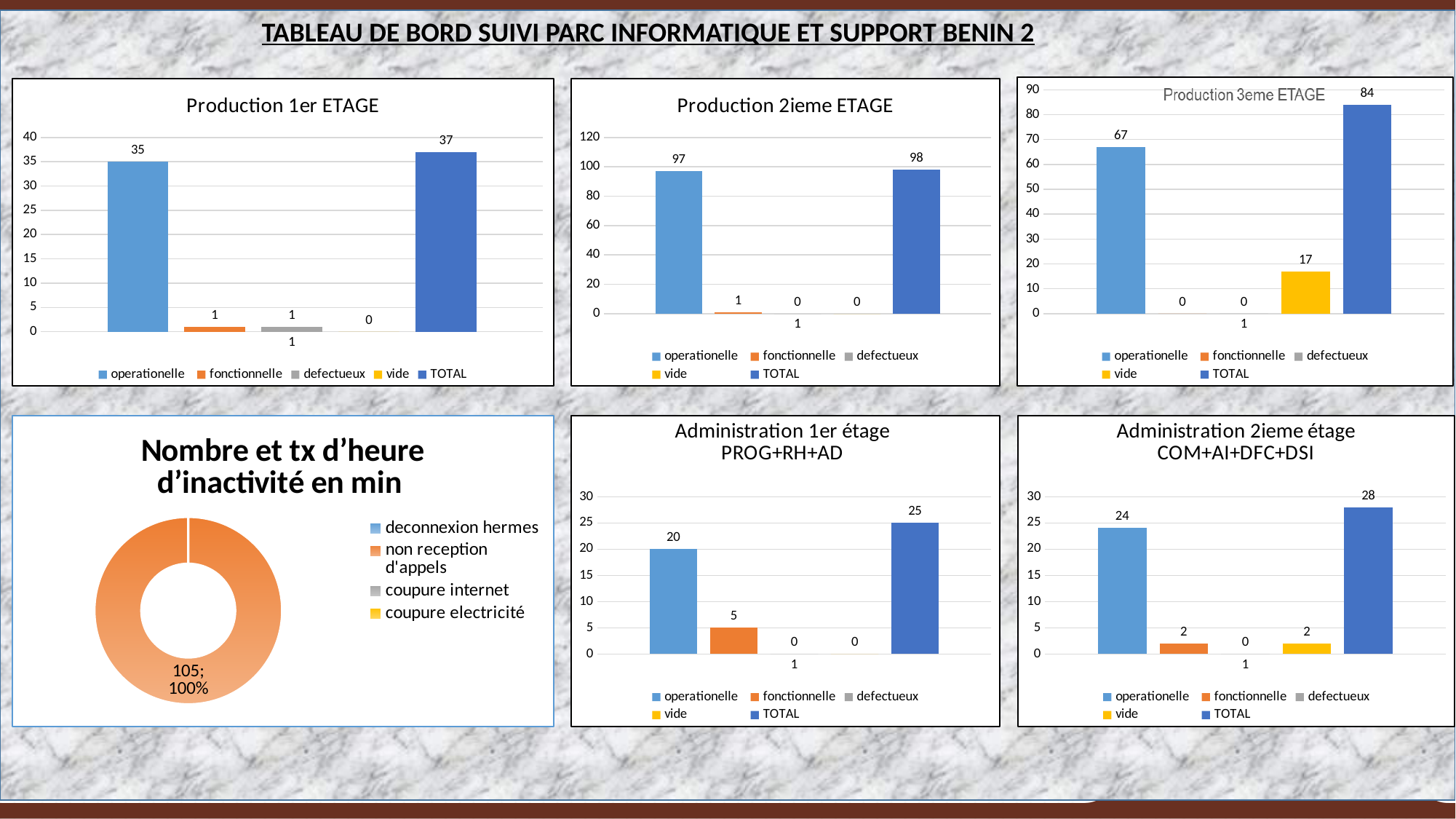
What kind of chart is 'Nombre et tx d'heure d'inactivité en min'? Doughnut chart In the 'Production 2ieme ETAGE' chart, what is the difference between TOTAL and operationelle? 1 In the 'Production 3eme ETAGE' chart, what is the value for vide? 17 In the 'Production 2ieme ETAGE' chart, what is the value for operationelle? 97 In the 'Production 1er ETAGE' chart, what is the value for operationelle? 35 Which is larger: the TOTAL in the 'Administration 1er étage' chart or the TOTAL in the 'Administration 2ieme étage' chart? Administration 2ieme étage In the 'Administration 2ieme étage COM+AI+DFC+DSI' chart, what is the value for TOTAL? 28 In the 'Administration 1er étage PROG+RH+AD' chart, what is the value for fonctionnelle? 5 In the 'Production 3eme ETAGE' chart, which series has the highest value? TOTAL In the 'Production 1er ETAGE' chart, what is the value for TOTAL? 37 How many series does the legend of the 'Production 1er ETAGE' chart list? 5 In the 'Production 3eme ETAGE' chart, what is the difference between TOTAL and operationelle? 17